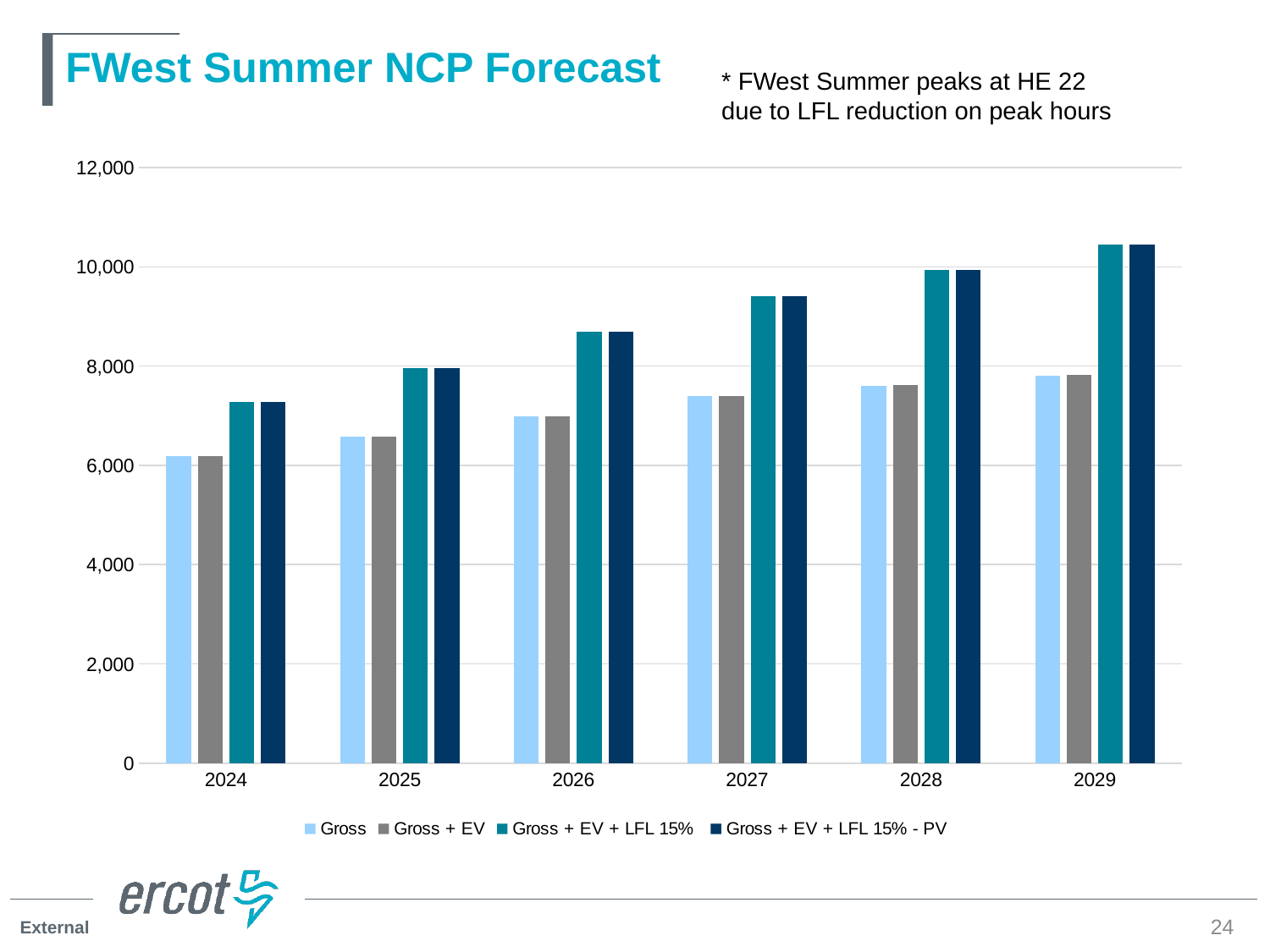
What is the last series listed in the chart's legend? Gross + EV + LFL 15% - PV What is the title of the chart? FWest Summer NCP Forecast Do the Gross values rise or fall from 2024 to 2029? rise Is the Gross + EV + LFL 15% value for 2027 greater or less than 10,000? less What kind of chart is shown on the slide? bar chart Is the Gross value for 2024 greater or less than 8,000? less Which year has the highest Gross value? 2029 Which year has the lowest Gross + EV + LFL 15% - PV value? 2024 How many years are shown on the x axis of the chart? 6 Is the Gross value for 2026 greater or less than 6,000? greater How many series does the chart's legend list? 4